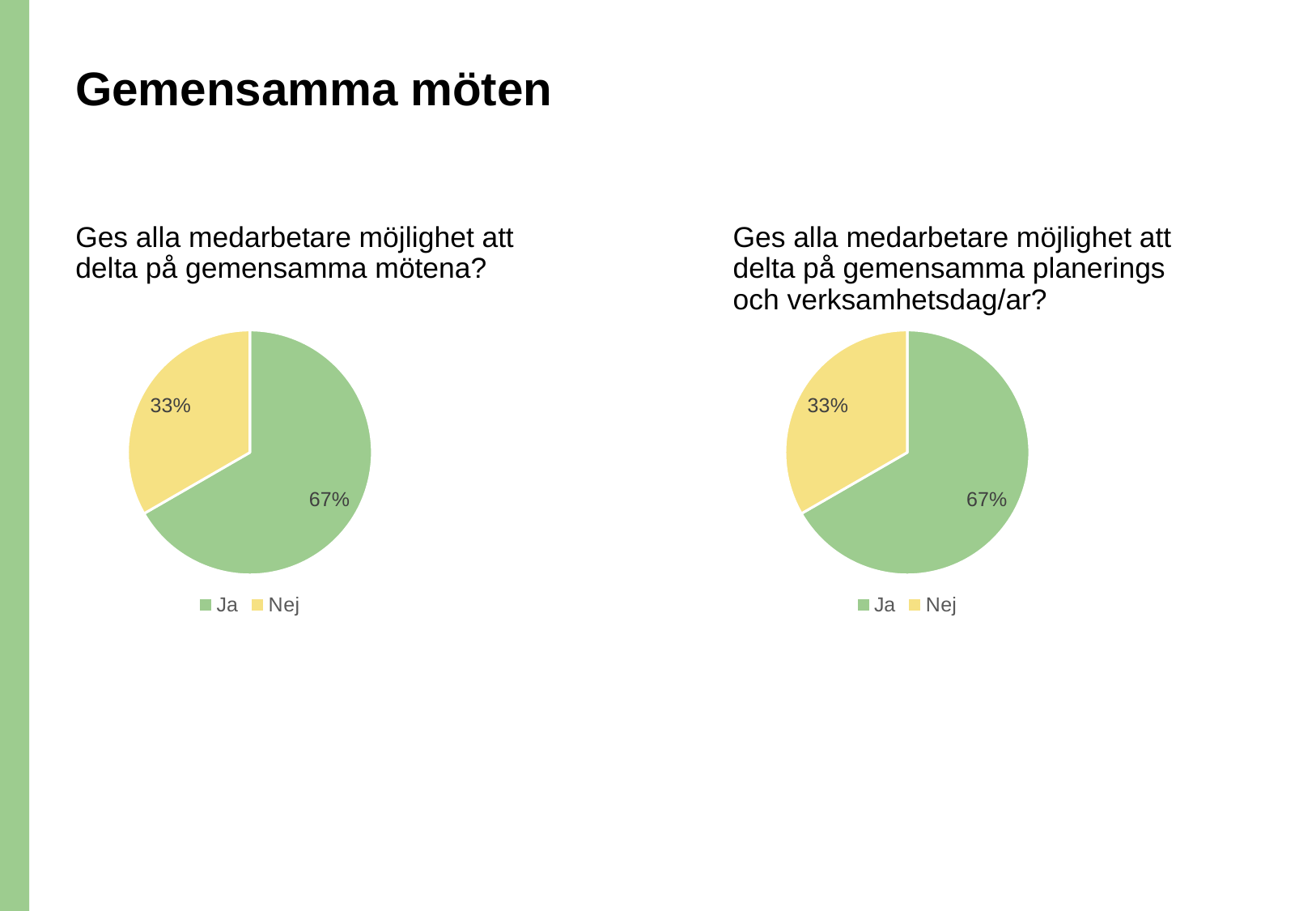
In the right pie chart, which category has the smallest slice? Nej In the right pie chart, which is larger, Ja or Nej? Ja In the left pie chart ("Ges alla medarbetare möjlighet att delta på gemensamma mötena?"), what share is labelled for Nej? 33% In the left pie chart, what is the difference in percentage points between Ja and Nej? 34 percentage points How many pie charts are shown on the slide? 2 In the right pie chart ("Ges alla medarbetare möjlighet att delta på gemensamma planerings och verksamhetsdag/ar?"), what share is labelled for Ja? 67% What kind of chart is used on the left of the slide? Pie chart In the left pie chart ("Ges alla medarbetare möjlighet att delta på gemensamma mötena?"), what share is labelled for Ja? 67% In the right pie chart ("Ges alla medarbetare möjlighet att delta på gemensamma planerings och verksamhetsdag/ar?"), what share is labelled for Nej? 33% In the left pie chart, which category has the largest slice? Ja How many categories does the legend of the right pie chart list? 2 In the left pie chart, what colour represents Nej? Yellow